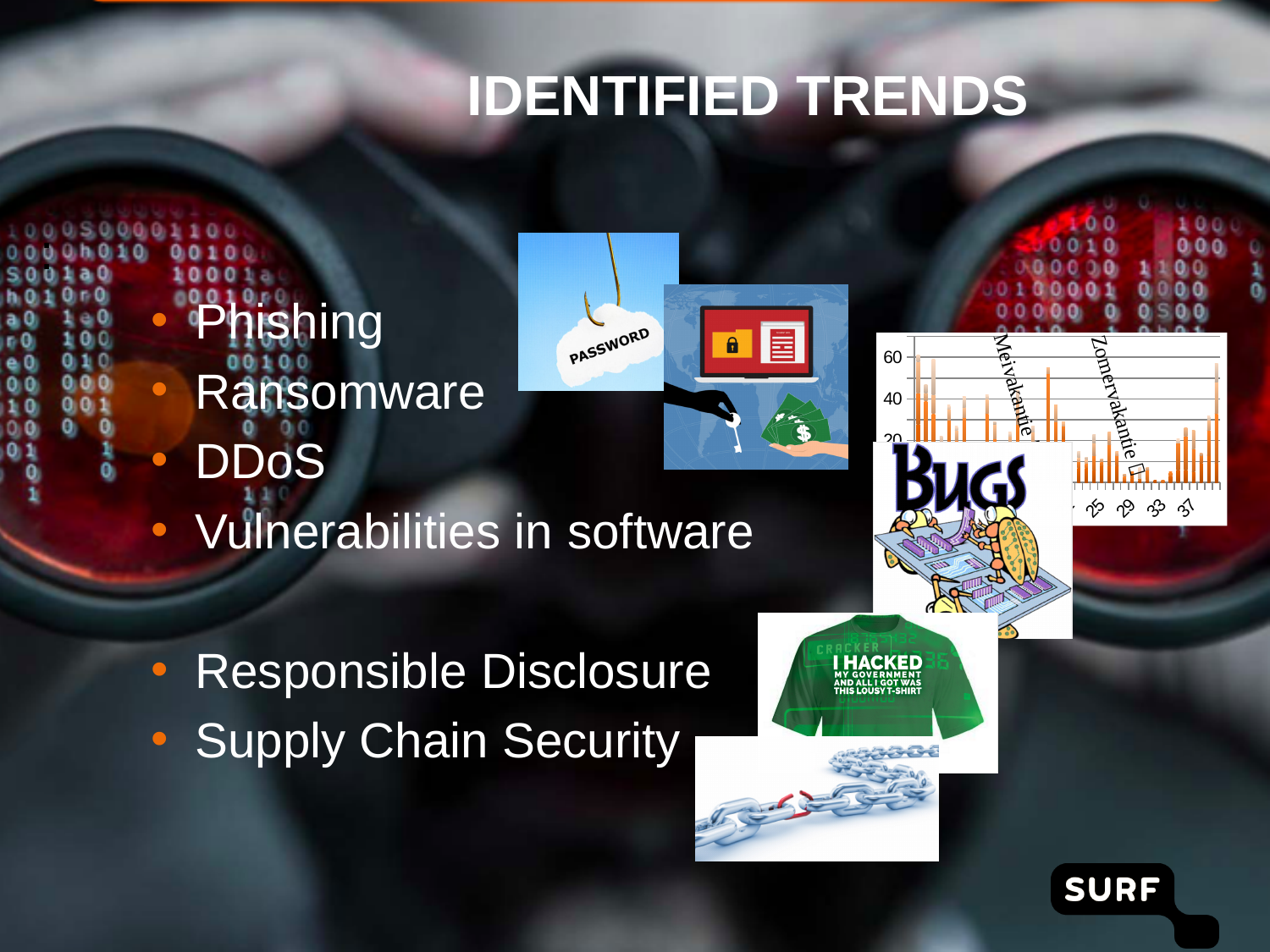
What kind of chart is shown on the right side of the slide, partly covered by the 'Bugs' image? bar chart In the chart on the right side of the slide, is the tallest bar near the right end (around x tick 37) greater or less than 40? greater What is the highest value labelled on the y axis of the chart on the right side of the slide? 60 What colour are the bars in the chart on the right side of the slide? orange